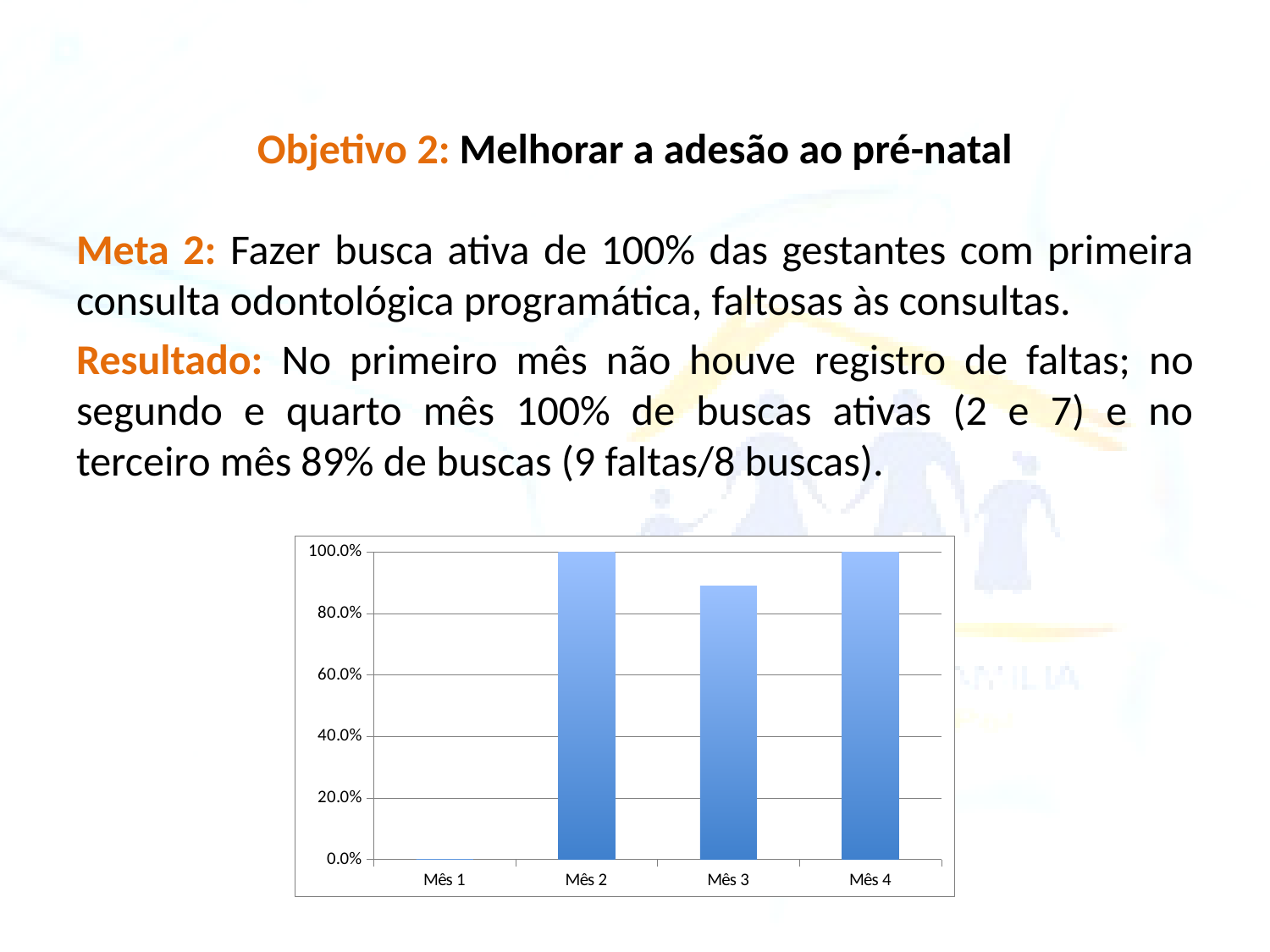
Is the value for Mês 3 greater or less than 100.0%? less What is the difference between the values for Mês 2 and Mês 1? 100.0% What colour are the bars in the chart? blue Which category has the lowest value in the chart? Mês 1 What is the value for Mês 2 in the chart? 100.0% What is the value for Mês 1 in the chart? 0.0% Is the value for Mês 3 greater or less than 80.0%? greater What is the value for Mês 4 in the chart? 100.0% Which is larger, the value for Mês 2 or the value for Mês 3? Mês 2 What kind of chart is shown on the slide? bar chart How many categories are shown on the x axis of the chart? 4 Which is larger, the value for Mês 1 or the value for Mês 3? Mês 3